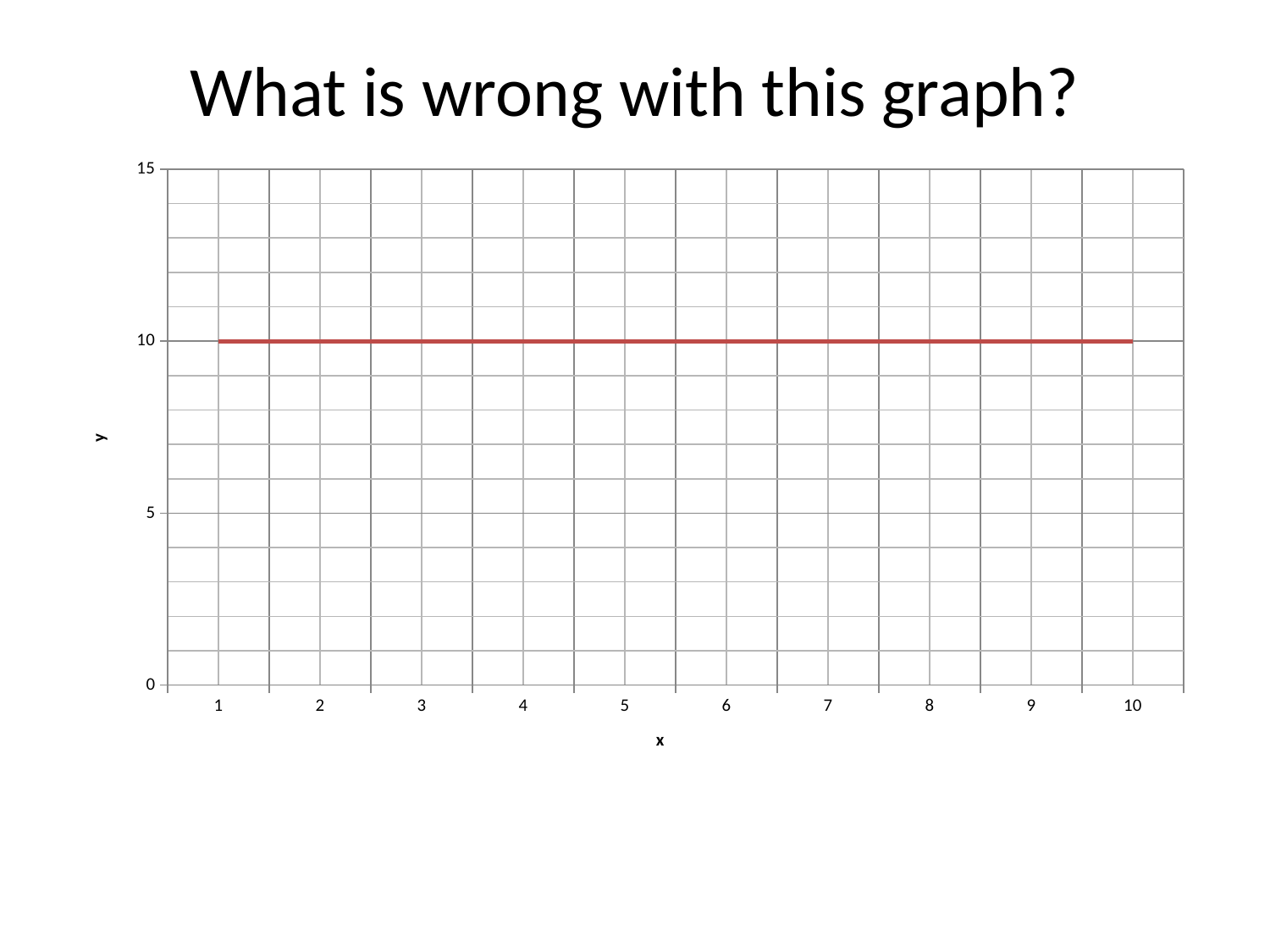
Is the value of y at x = 7 greater or less than 15? less What is the value of y when x is 10? 10 What is the label on the horizontal axis? x How many x values are labelled on the horizontal axis? 10 What is the difference between the y value at x = 2 and the y value at x = 8? 0 What kind of chart is shown on the slide? line chart What is the highest value shown on the vertical axis? 15 Is the value of y at x = 3 greater or less than 5? greater Do the values rise, fall, or stay flat as x increases from 1 to 10? stay flat What is the value of y when x is 1? 10 What is the label on the vertical axis? y What is the value of y when x is 5? 10